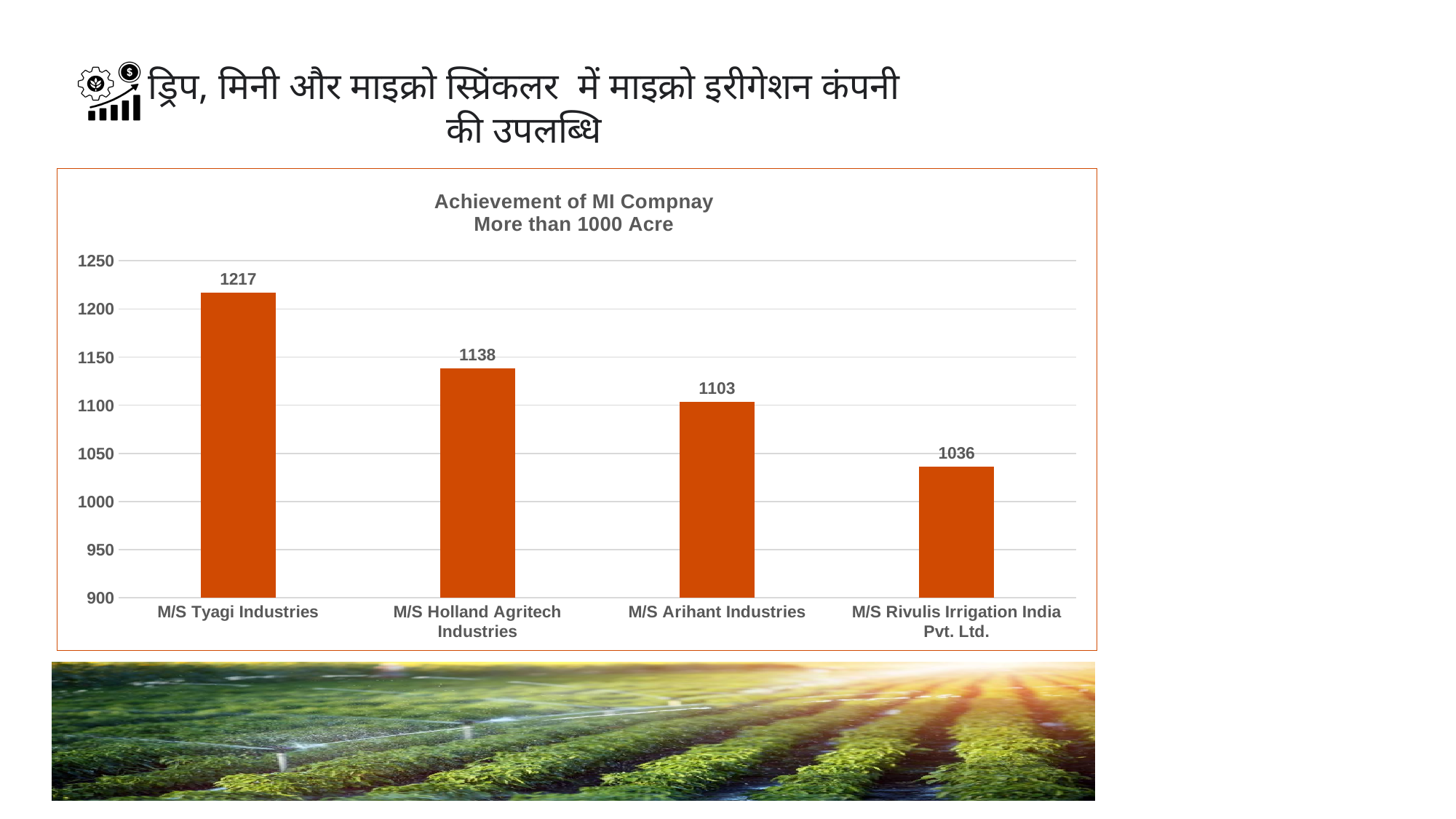
What is the value for M/S Arihant Industries? 1103 How many companies are shown in the chart? 4 Is the value for M/S Arihant Industries greater or less than 1150? less Which is larger, the value for M/S Holland Agritech Industries or M/S Arihant Industries? M/S Holland Agritech Industries What is the value for M/S Tyagi Industries? 1217 What is the value for M/S Rivulis Irrigation India Pvt. Ltd.? 1036 What is the title of the chart? Achievement of MI Compnay More than 1000 Acre Which company has the highest value? M/S Tyagi Industries What is the difference between the values for M/S Tyagi Industries and M/S Rivulis Irrigation India Pvt. Ltd.? 181 What is the value for M/S Holland Agritech Industries? 1138 What kind of chart is shown on the slide? Bar chart Which company has the lowest value? M/S Rivulis Irrigation India Pvt. Ltd.